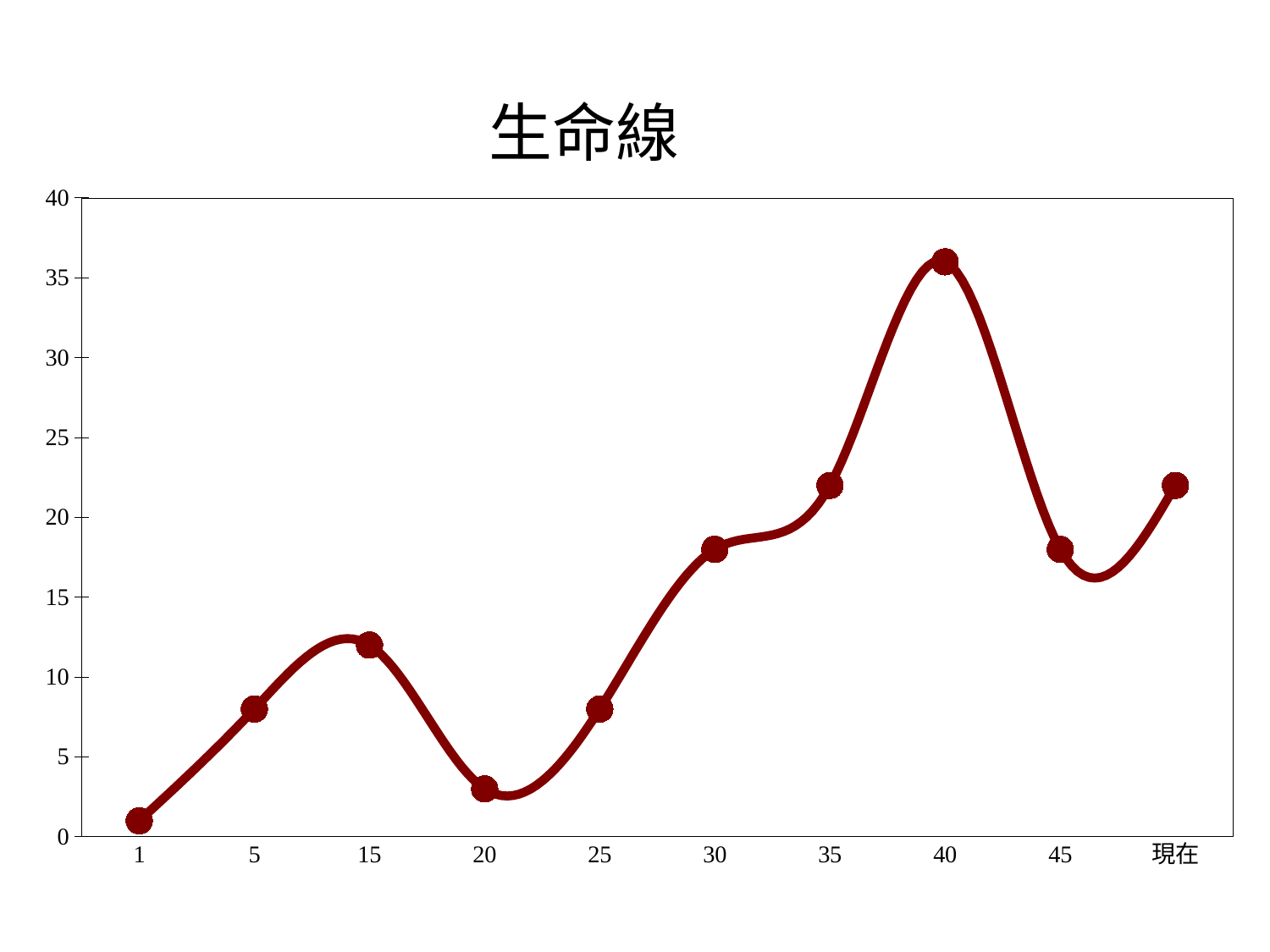
Which has the larger value, 35 or 25? 35 Is the value at 5 greater or less than 10? less Which has the larger value, 15 or 20? 15 Is the value at 40 greater or less than 30? greater Is the value at 20 greater or less than 5? less What kind of chart is shown on the slide? line chart What is the title of the chart? 生命線 Which has the larger value, 40 or 45? 40 How many data points are plotted on the line? 10 At which x-axis category does the line reach its highest value? 40 Does the line rise or fall between 40 and 45? fall